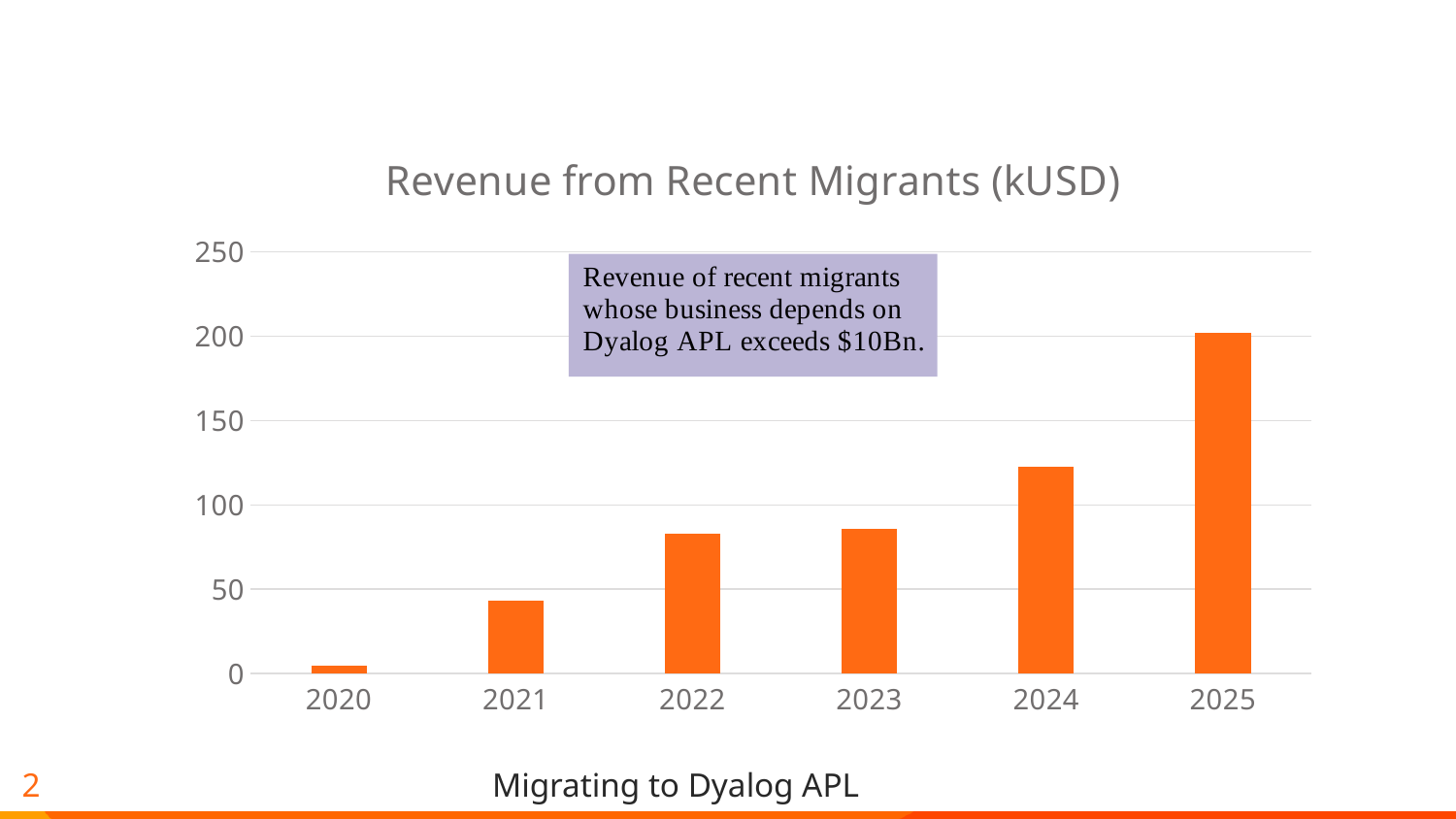
How many years are shown on the x axis of the chart? 6 What is the title of the chart? Revenue from Recent Migrants (kUSD) Is the value for 2021 greater or less than 50? less Is the value for 2024 greater or less than 100? greater What colour are the bars in the chart? orange Which year has the highest revenue in the chart? 2025 Is the value for 2025 greater or less than 150? greater Which year has the lowest revenue in the chart? 2020 What type of chart is shown on the slide? bar chart Do the revenue values rise or fall from 2020 to 2025? rise Which year has the larger revenue, 2021 or 2024? 2024